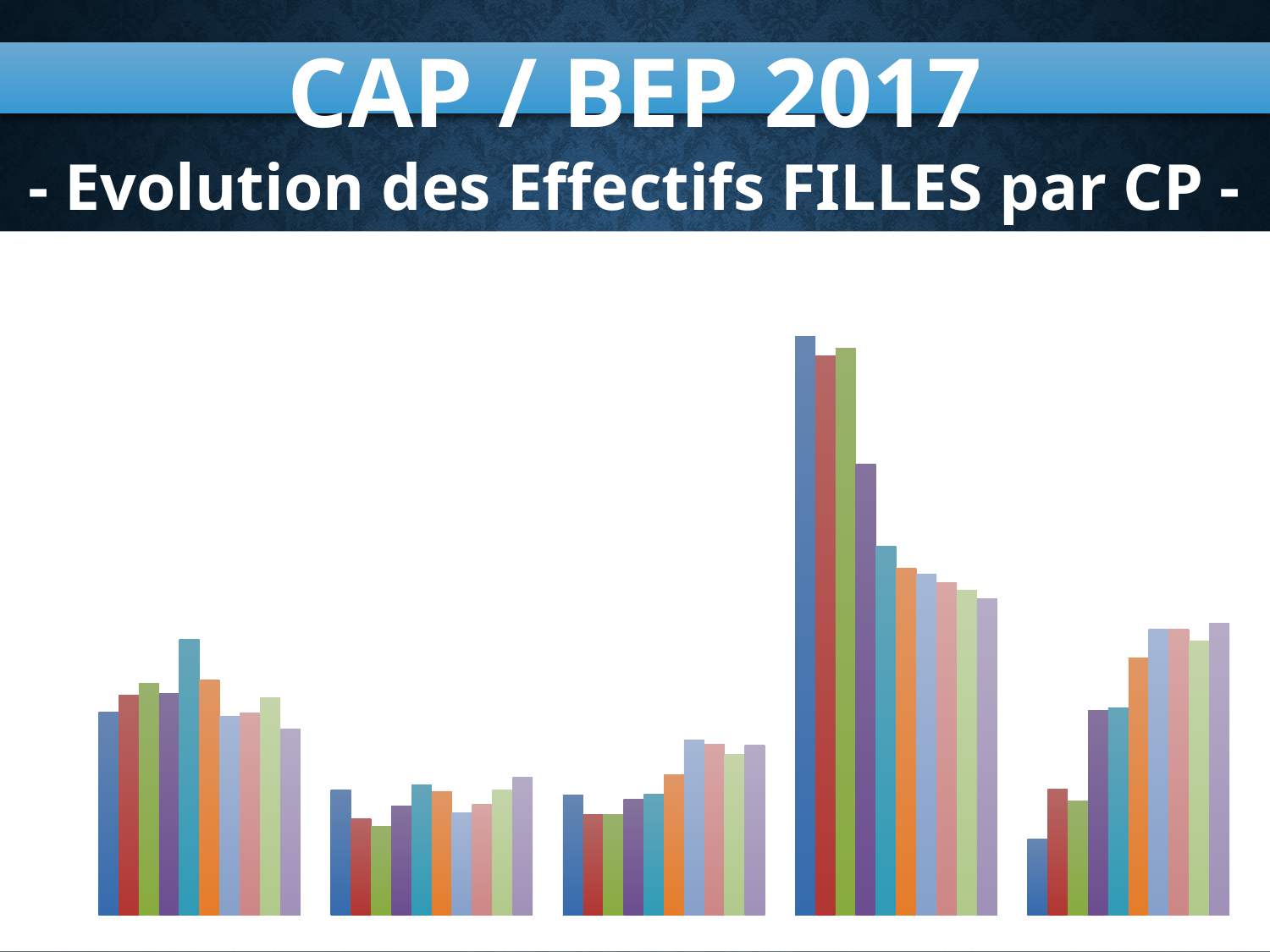
How many groups of bars does the chart contain? 5 Within the fifth group from the left, do the bars generally rise or fall from left to right? rise Which group of bars, counting from the left, has the lowest bars overall on the chart? the second group What is the main title at the top of the slide? CAP / BEP 2017 Is the last bar of the fifth group taller or shorter than the last bar of the second group? taller Which group of bars, counting from the left, contains the tallest bars on the chart? the fourth group Within the third group from the left, do the bars generally rise or fall from left to right? rise Is the first bar of the fourth group taller or shorter than the first bar of the fifth group? taller What kind of chart is shown on the slide? bar chart How many bars are there in each group of the chart? 10 Within the fourth group from the left, do the bars generally rise or fall from left to right? fall What is the subtitle of the chart shown on the slide? - Evolution des Effectifs FILLES par CP -